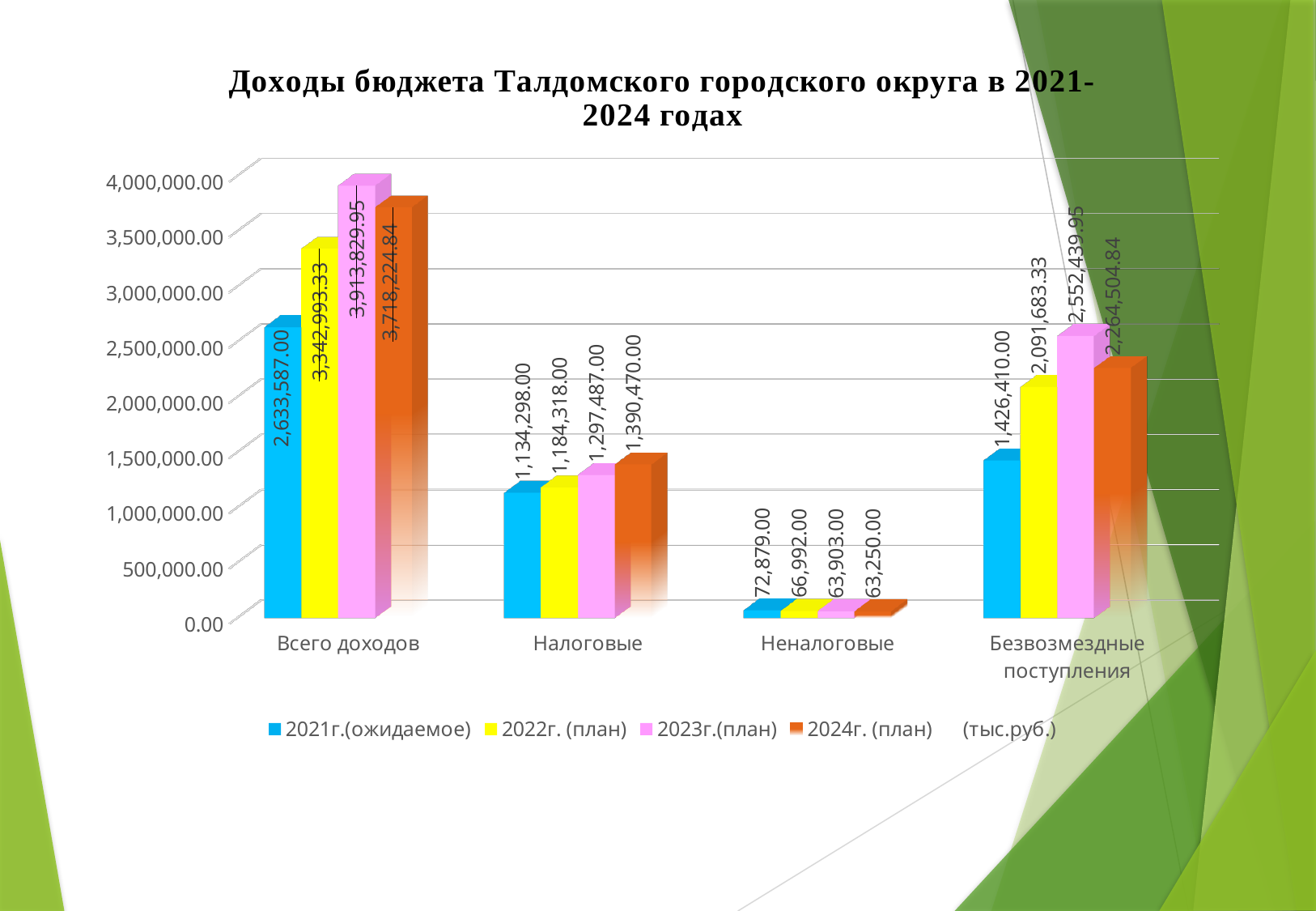
How many series does the legend list with colour markers? 4 Which is larger for Безвозмездные поступления: the 2022г. (план) value or the 2024г. (план) value? 2024г. (план) Which series has the highest value for Всего доходов? 2023г.(план) What kind of chart is shown on the slide? bar chart What is the difference between the 2024г. (план) and 2021г.(ожидаемое) values for Налоговые? 256,172.00 What is the value for Неналоговые in the 2024г. (план) series? 63,250.00 What is the value for Налоговые in the 2021г.(ожидаемое) series? 1,134,298.00 What is the value for Безвозмездные поступления in the 2022г. (план) series? 2,091,683.33 Do the values for Налоговые rise or fall from the 2021 series to the 2024 series? rise Which category has the lowest values across all series? Неналоговые What is the difference between the 2023г.(план) and 2024г. (план) values for Всего доходов? 195,605.11 What is the value for Всего доходов in the 2023г.(план) series? 3,913,829.95